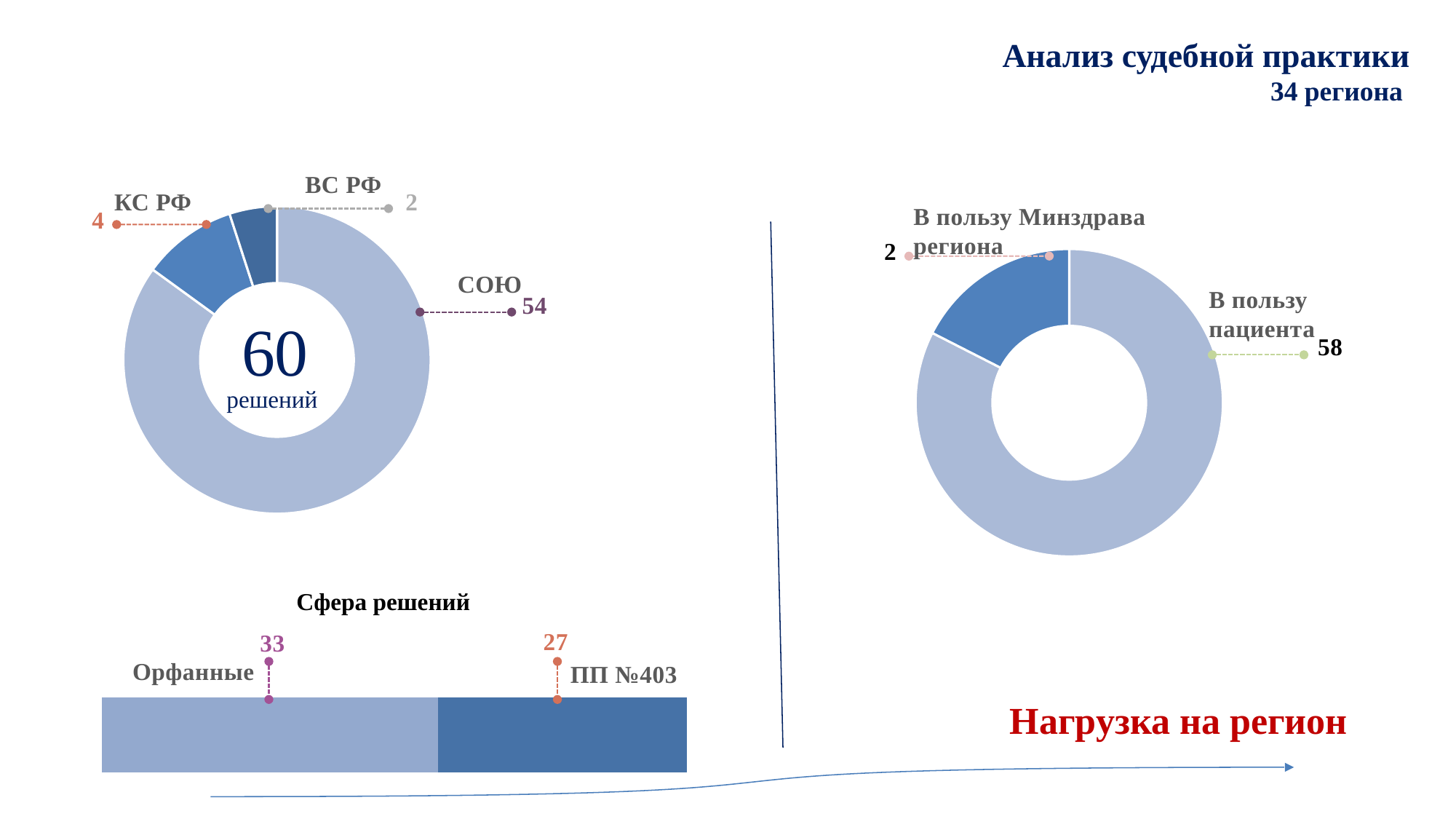
In the bottom-left chart titled Сфера решений, what is the total of the stacked bar (Орфанные plus ПП №403)? 60 In the top-left donut chart (60 решений), what is the value for КС РФ? 4 What kind of chart is the bottom-left chart titled Сфера решений? Stacked bar chart In the top-left donut chart (60 решений), which category has the highest value? СОЮ In the top-left donut chart (60 решений), what is the value for СОЮ? 54 In the top-right donut chart, what is the value for В пользу Минздрава региона? 2 In the top-left donut chart (60 решений), which category has the lowest value? ВС РФ In the top-left donut chart (60 решений), what is the difference between СОЮ and КС РФ? 50 In the bottom-left chart titled Сфера решений, what is the value for Орфанные? 33 In the top-right donut chart, which is larger: В пользу пациента or В пользу Минздрава региона? В пользу пациента In the top-right donut chart, what is the value for В пользу пациента? 58 In the top-left donut chart (60 решений), how many categories are shown? 3